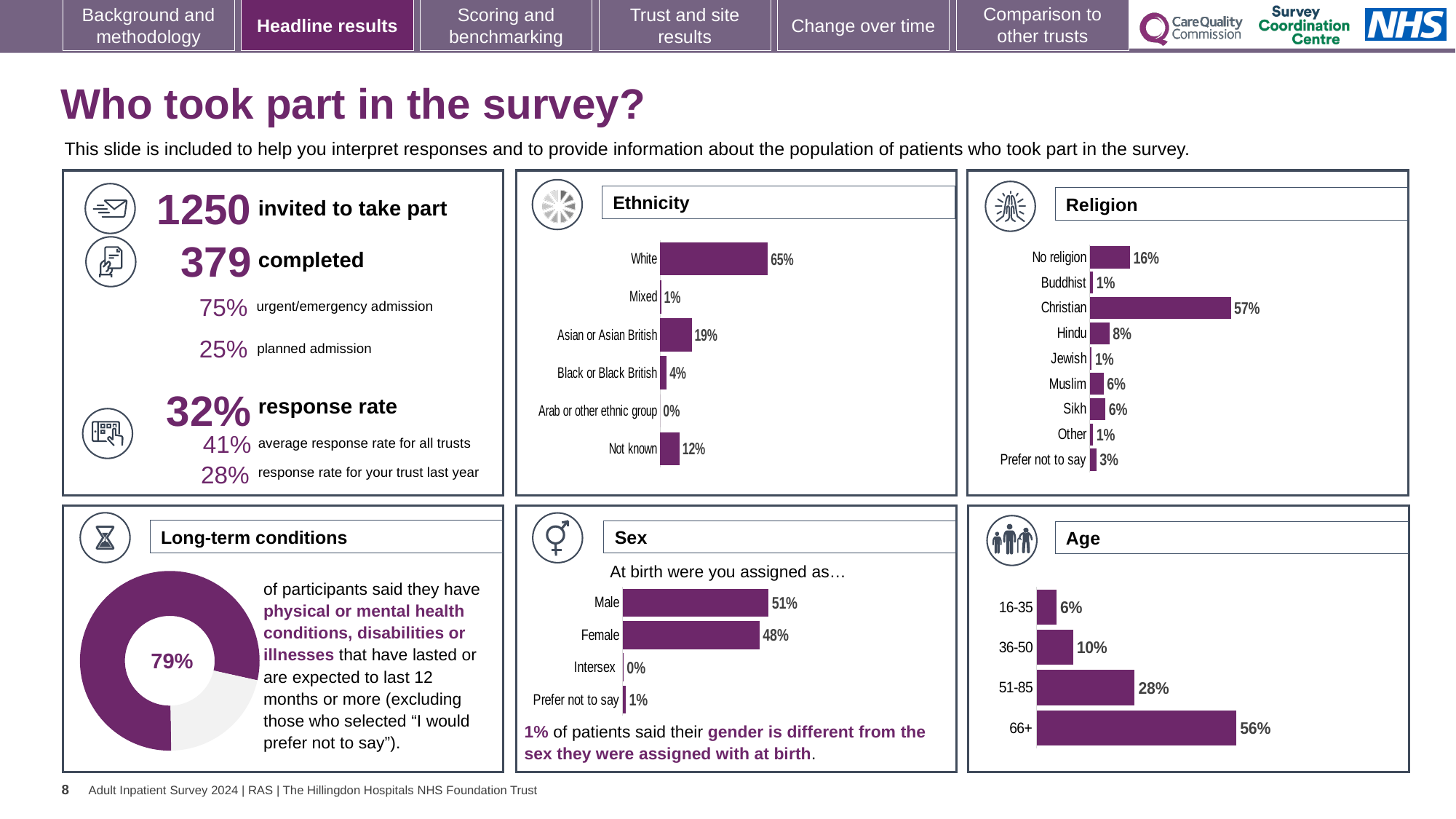
In the Age chart, what is the difference between the 66+ and 51-85 values? 28% In the Religion chart, what is the value for Hindu? 8% What kind of chart is the Long-term conditions chart? Doughnut chart In the Religion chart, which category has the highest value? Christian In the Ethnicity chart, what is the value for Not known? 12% In the Age chart, do the values rise or fall from 16-35 to 66+? Rise How many categories does the Religion chart show? 9 How many categories does the Ethnicity chart show? 6 In the Sex chart, which is larger, Male or Female? Male What kind of chart is the Age chart? Bar chart In the Long-term conditions chart, what share of participants said they have physical or mental health conditions, disabilities or illnesses? 79% In the Ethnicity chart, what percentage of respondents were White? 65%